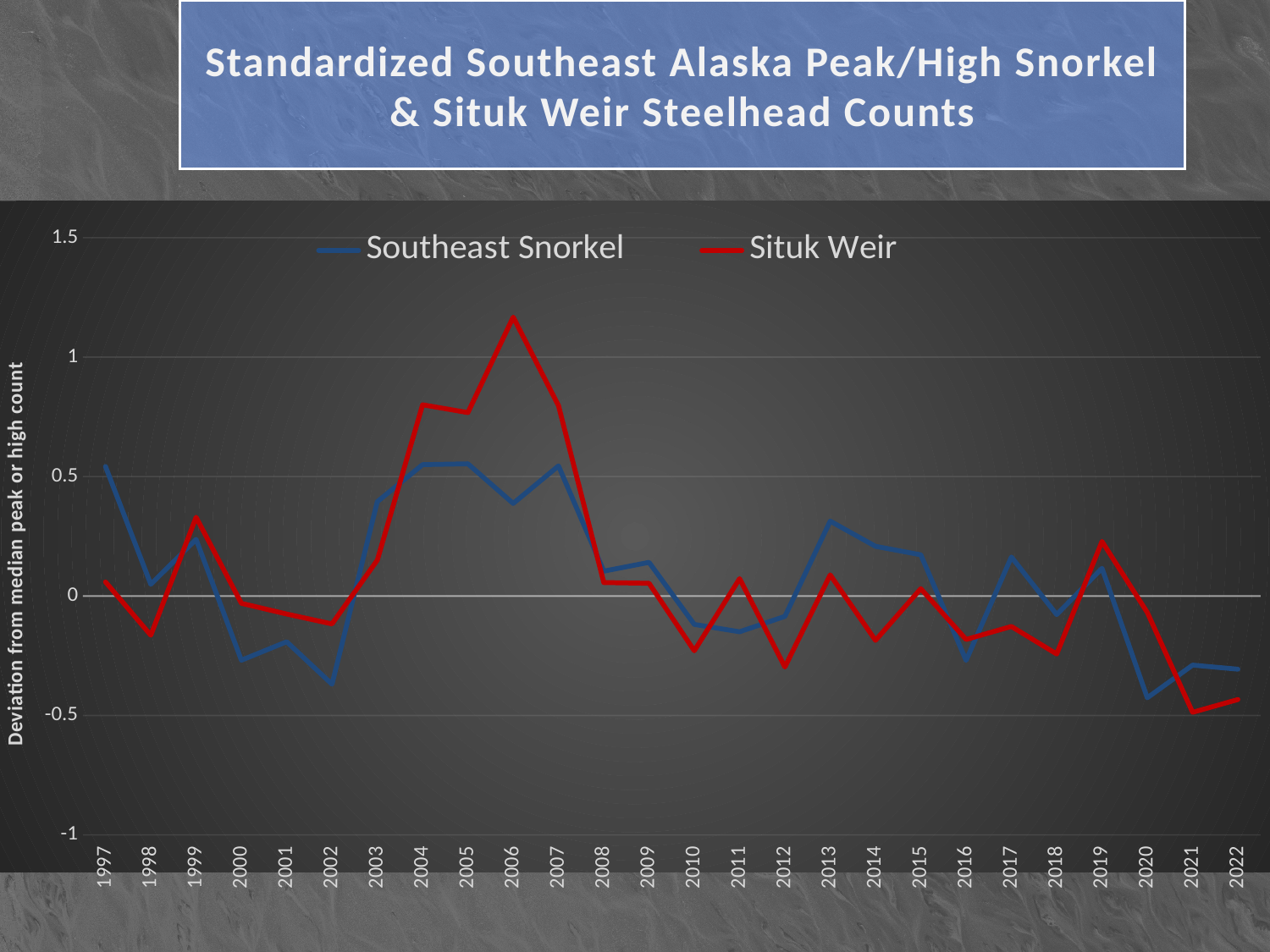
In 2013, which series has the larger value, Southeast Snorkel or Situk Weir? Southeast Snorkel Is the Southeast Snorkel value for 2002 greater or less than 0? less Do the Situk Weir values rise or fall from 2019 to 2021? fall What colour is the line for the Situk Weir series? red What kind of chart is shown on the slide? line chart Is the Situk Weir value for 2006 greater or less than 1? greater Is the Southeast Snorkel value for 2004 greater or less than 0.5? greater In 2006, which series has the larger value, Southeast Snorkel or Situk Weir? Situk Weir How many years are shown along the x axis? 26 How many series does the legend list? 2 In which year does the Situk Weir series reach its lowest value? 2021 In which year does the Situk Weir series reach its highest value? 2006